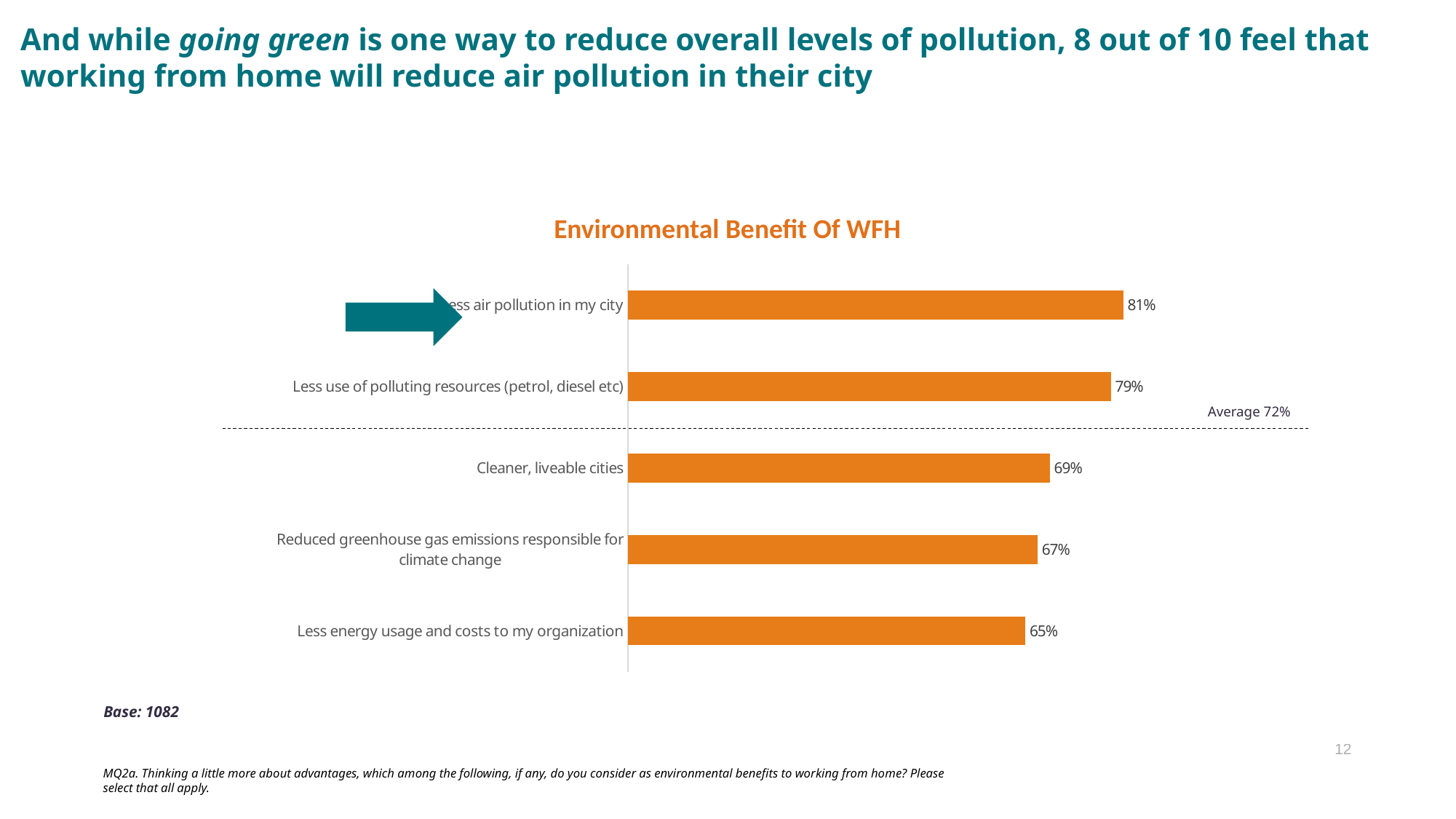
What is the difference between 'Less air pollution in my city' and 'Less energy usage and costs to my organization'? 16% What is the value for 'Cleaner, liveable cities'? 69% Which environmental benefit has the lowest percentage? Less energy usage and costs to my organization What percentage of respondents selected 'Less air pollution in my city' as an environmental benefit of WFH? 81% Which is larger: 'Cleaner, liveable cities' or 'Reduced greenhouse gas emissions responsible for climate change'? Cleaner, liveable cities What is the value for 'Reduced greenhouse gas emissions responsible for climate change'? 67% What is the value for 'Less energy usage and costs to my organization'? 65% Which environmental benefit has the highest percentage? Less air pollution in my city What kind of chart is shown on the slide? Bar chart How many environmental benefits are shown in the chart? 5 What average value is marked by the dashed line on the chart? Average 72% What is the value for 'Less use of polluting resources (petrol, diesel etc)'? 79%